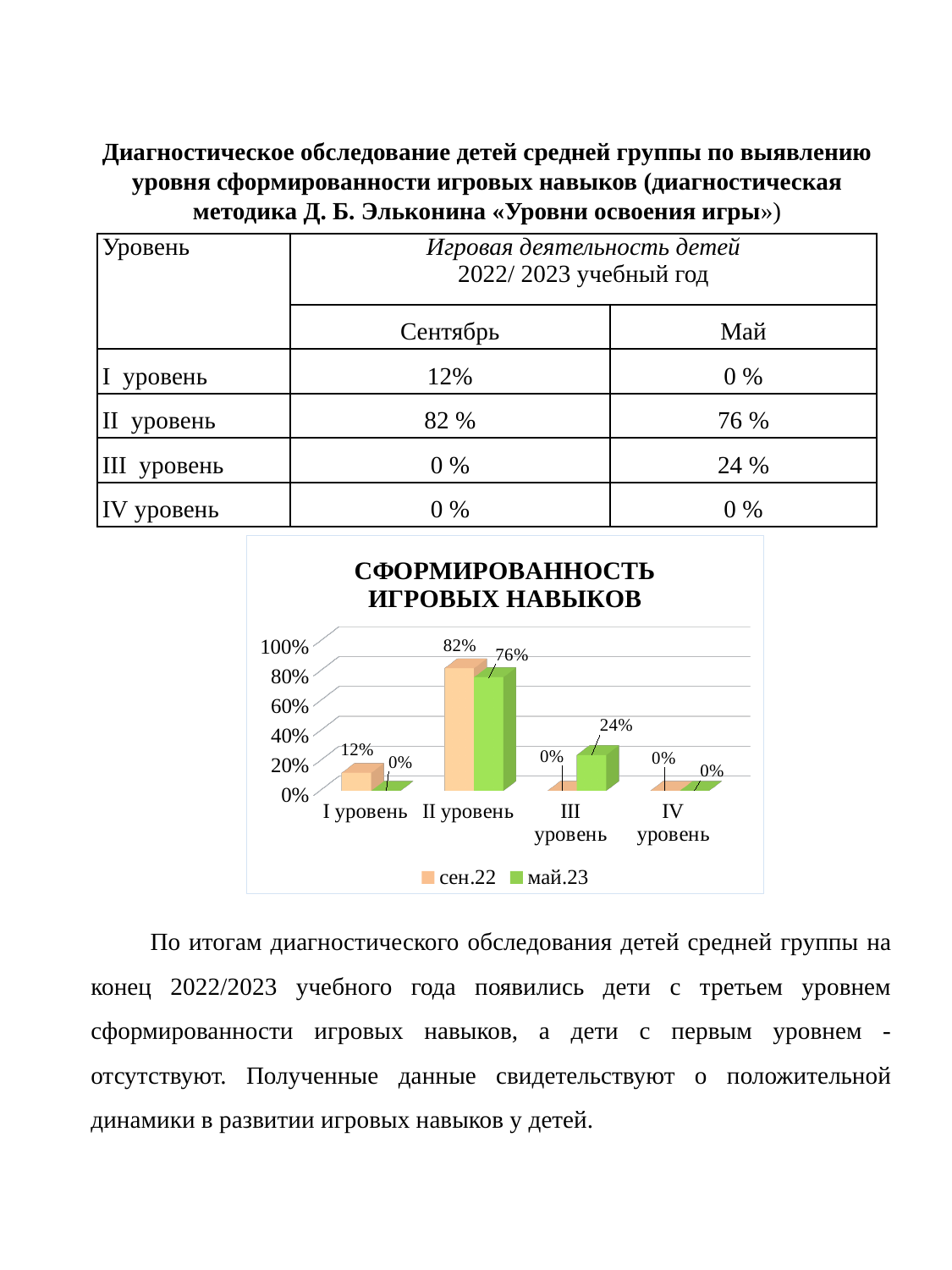
How many categories are shown on the x axis? 4 How many series does the legend list? 2 What is the value for II уровень in the сен.22 series? 82% What kind of chart is shown? bar chart What is the difference between the сен.22 and май.23 values for II уровень? 6% What is the title of the chart? СФОРМИРОВАННОСТЬ ИГРОВЫХ НАВЫКОВ Which category has the highest value in the май.23 series? II уровень Is the value for II уровень in the сен.22 series greater or less than 60%? greater Which is larger for I уровень: the сен.22 value or the май.23 value? сен.22 What is the value for III уровень in the май.23 series? 24% What is the value for II уровень in the май.23 series? 76% What is the value for I уровень in the сен.22 series? 12%